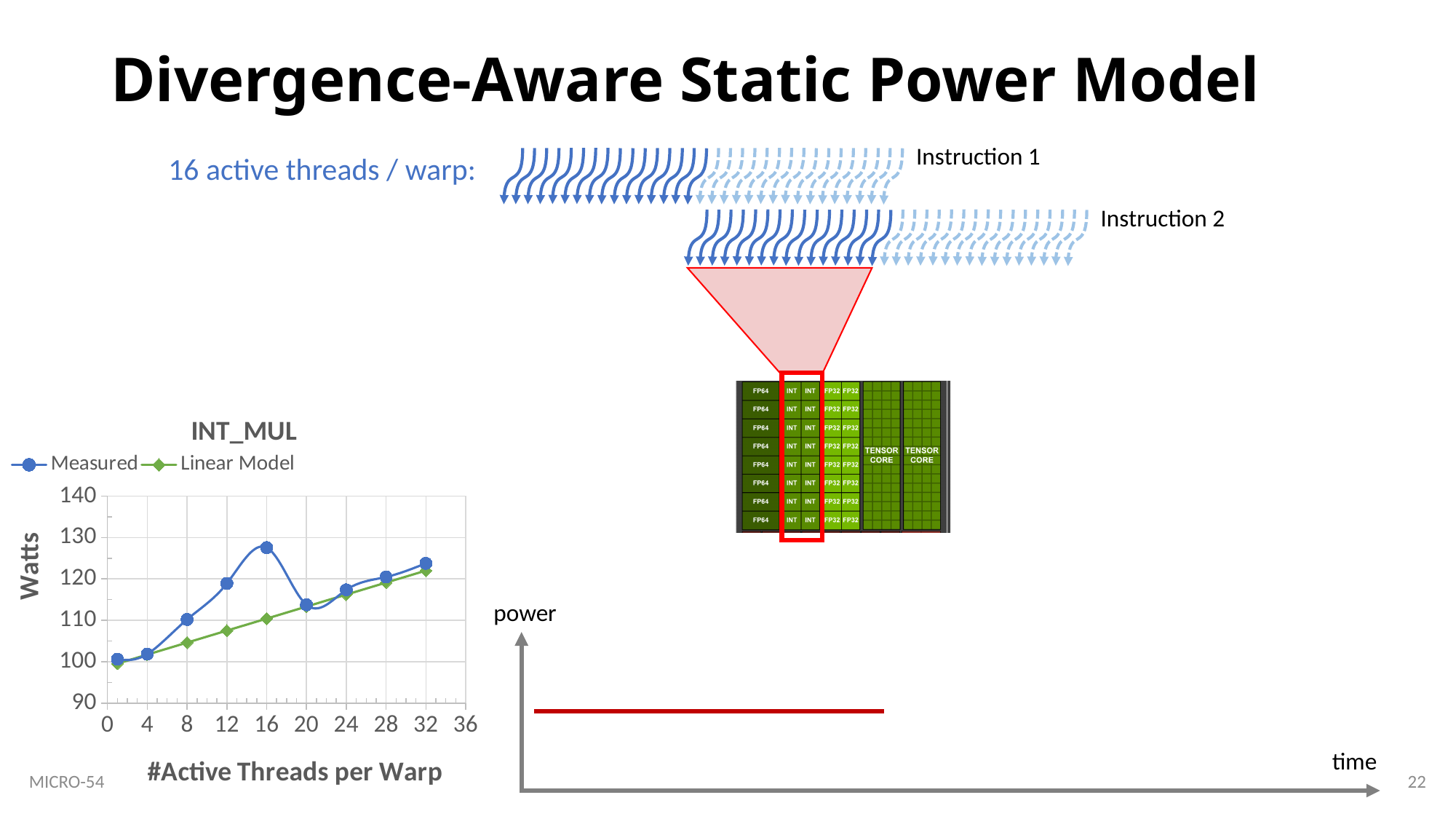
Is the Linear Model value at 16 active threads per warp greater or less than 120? less Is the Measured value at 16 active threads per warp greater or less than 120? greater Is the Measured value at 8 active threads per warp greater or less than 120? less How many data points does the Measured series have in the INT_MUL chart? 9 What are the two series named in the legend of the INT_MUL chart? Measured and Linear Model Do the Linear Model values rise or fall as the number of active threads per warp increases? rise At which number of active threads per warp does the Measured series reach its highest value? 16 How many series does the legend of the INT_MUL chart list? 2 What kind of chart is the INT_MUL chart? line chart What is the label of the y axis of the INT_MUL chart? Watts At 16 active threads per warp, which series has the larger value, Measured or Linear Model? Measured